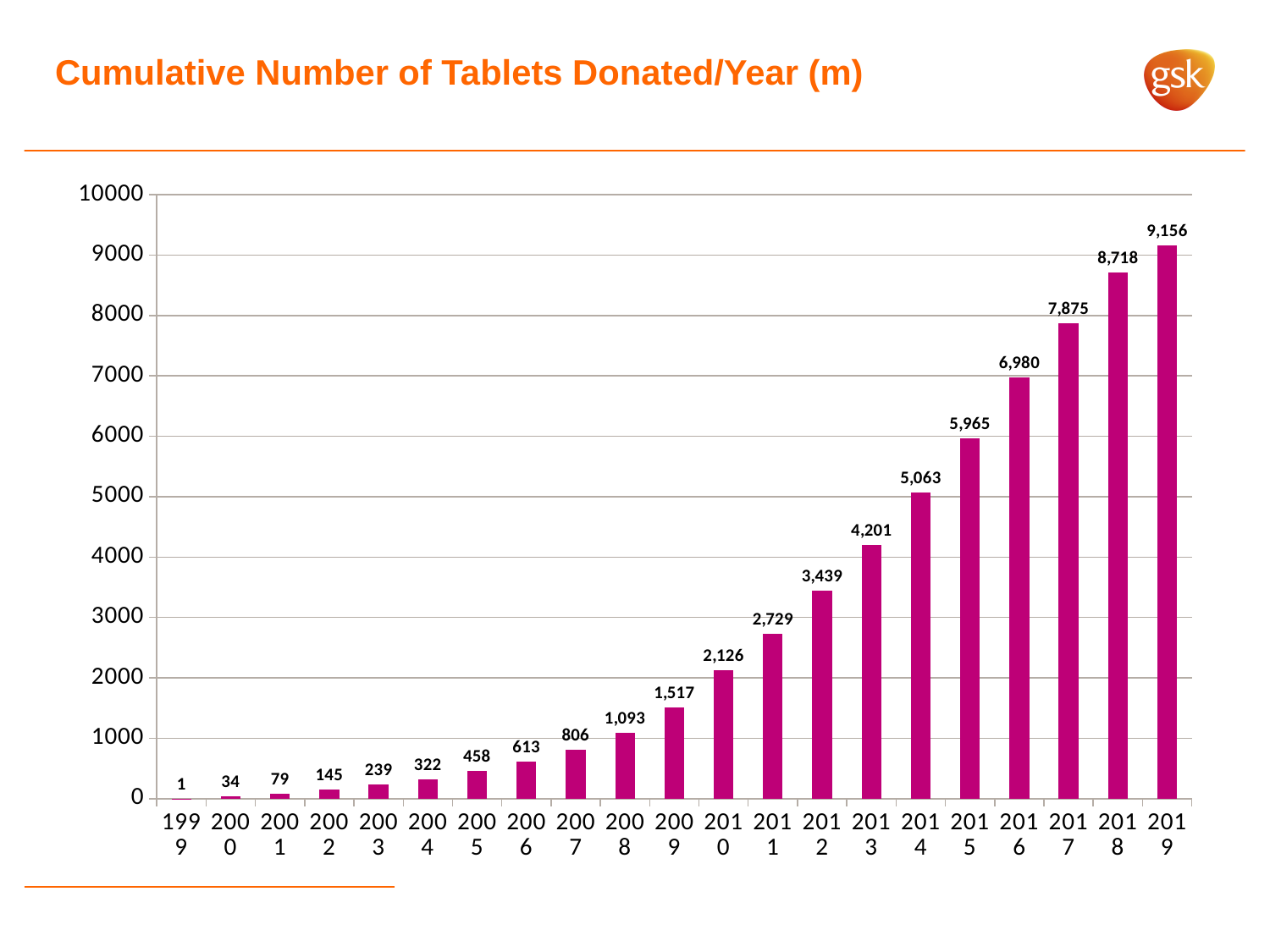
Is the value for 2016 greater or less than 7000? less What is the difference between the values for 2013 and 2012? 762 What is the cumulative number of tablets donated by 2019? 9,156 Which year has the highest value on the chart? 2019 Do the values rise or fall from 1999 to 2019? Rise How many years are shown on the x axis? 21 What kind of chart is shown on the slide? Bar chart What value is shown for 2005? 458 What value is shown for 2010? 2,126 Which year has the lowest value on the chart? 1999 Which is larger, the value for 2008 or the value for 2009? 2009 What is the difference between the values for 2019 and 2018? 438